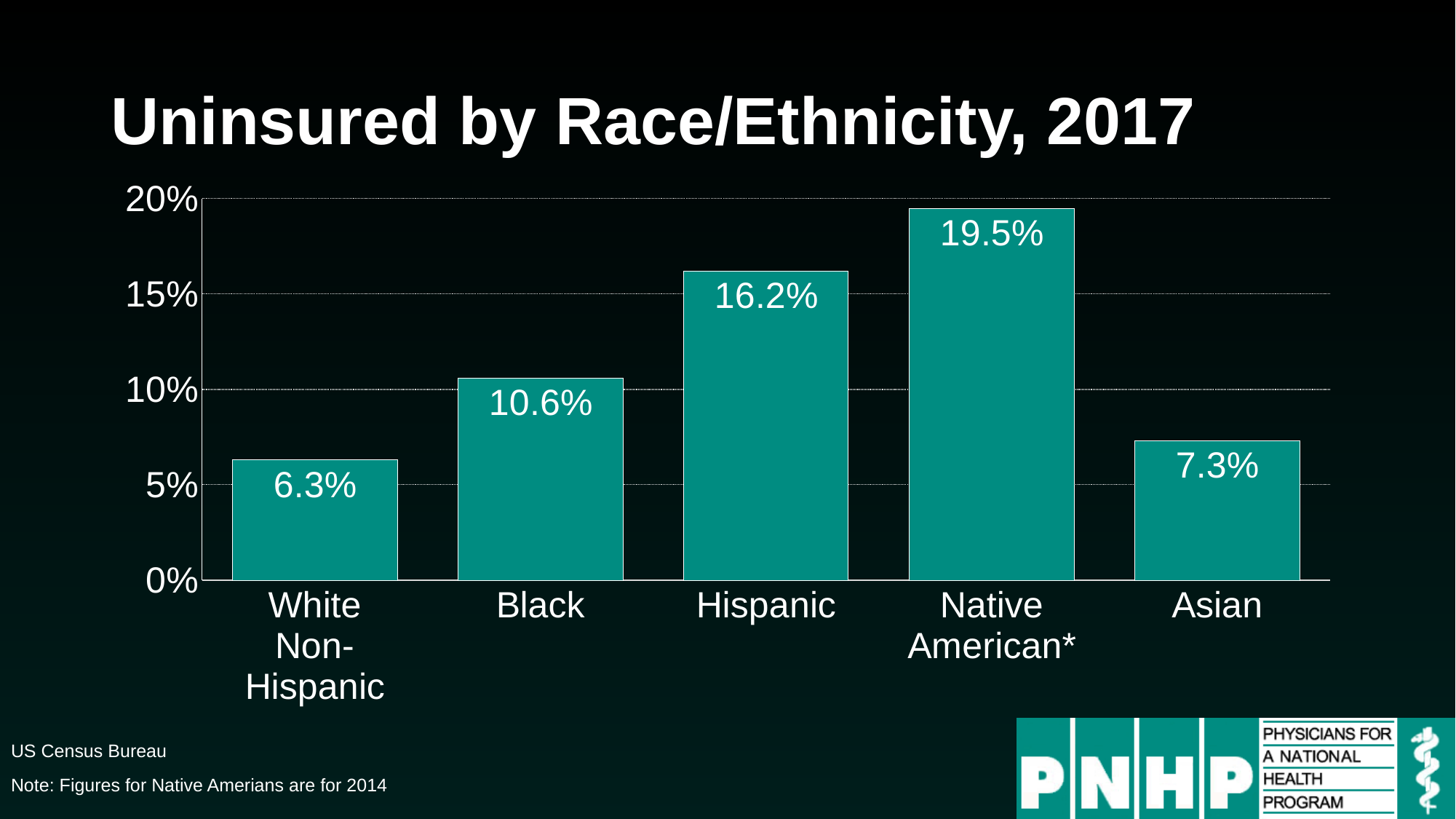
Which has a higher uninsured rate, Black or Hispanic? Hispanic What is the title of the chart? Uninsured by Race/Ethnicity, 2017 Is the value for Black greater or less than 10%? greater How many race/ethnicity categories are shown in the chart? 5 What is the uninsured rate for Hispanic? 16.2% What is the uninsured rate for White Non-Hispanic? 6.3% What kind of chart is shown on the slide? Bar chart What is the difference between the uninsured rates for Native American* and Black? 8.9% What is the uninsured rate for Asian? 7.3% What is the difference between the uninsured rates for Asian and White Non-Hispanic? 1.0% Which category has the highest uninsured rate? Native American* Which category has the lowest uninsured rate? White Non-Hispanic